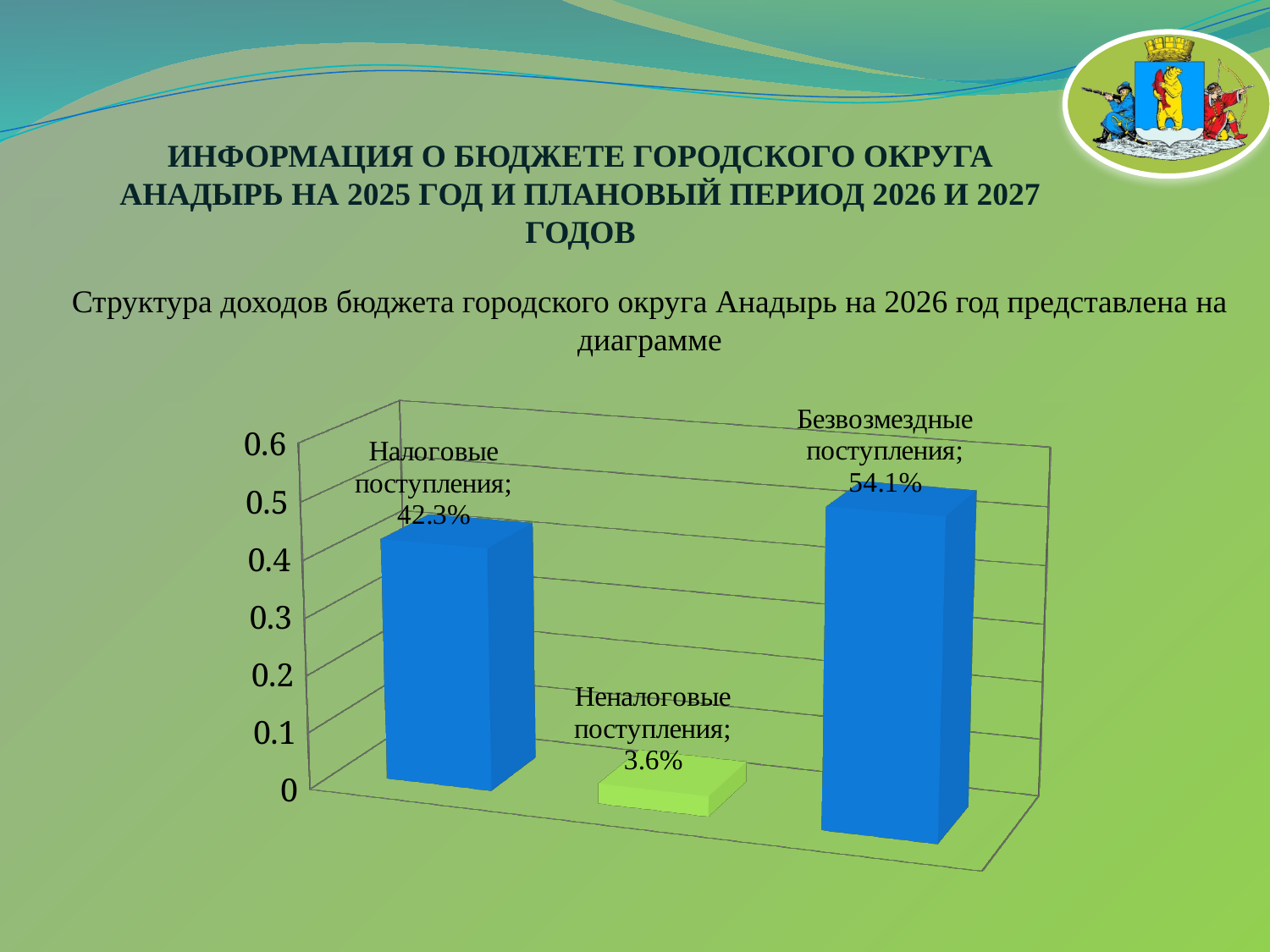
Which category has the highest value? Безвозмездные поступления What is the difference between Безвозмездные поступления and Налоговые поступления? 11.8% What is the value shown for Налоговые поступления? 42.3% Which category has the lowest value? Неналоговые поступления Which is larger, Налоговые поступления or Безвозмездные поступления? Безвозмездные поступления What is the difference between Налоговые поступления and Неналоговые поступления? 38.7% What kind of chart is shown on the slide? bar chart How many categories are shown in the chart? 3 Is the value for Налоговые поступления greater or less than 0.5? less What is the value shown for Неналоговые поступления? 3.6% What is the value shown for Безвозмездные поступления? 54.1% What is the highest value shown on the vertical axis? 0.6